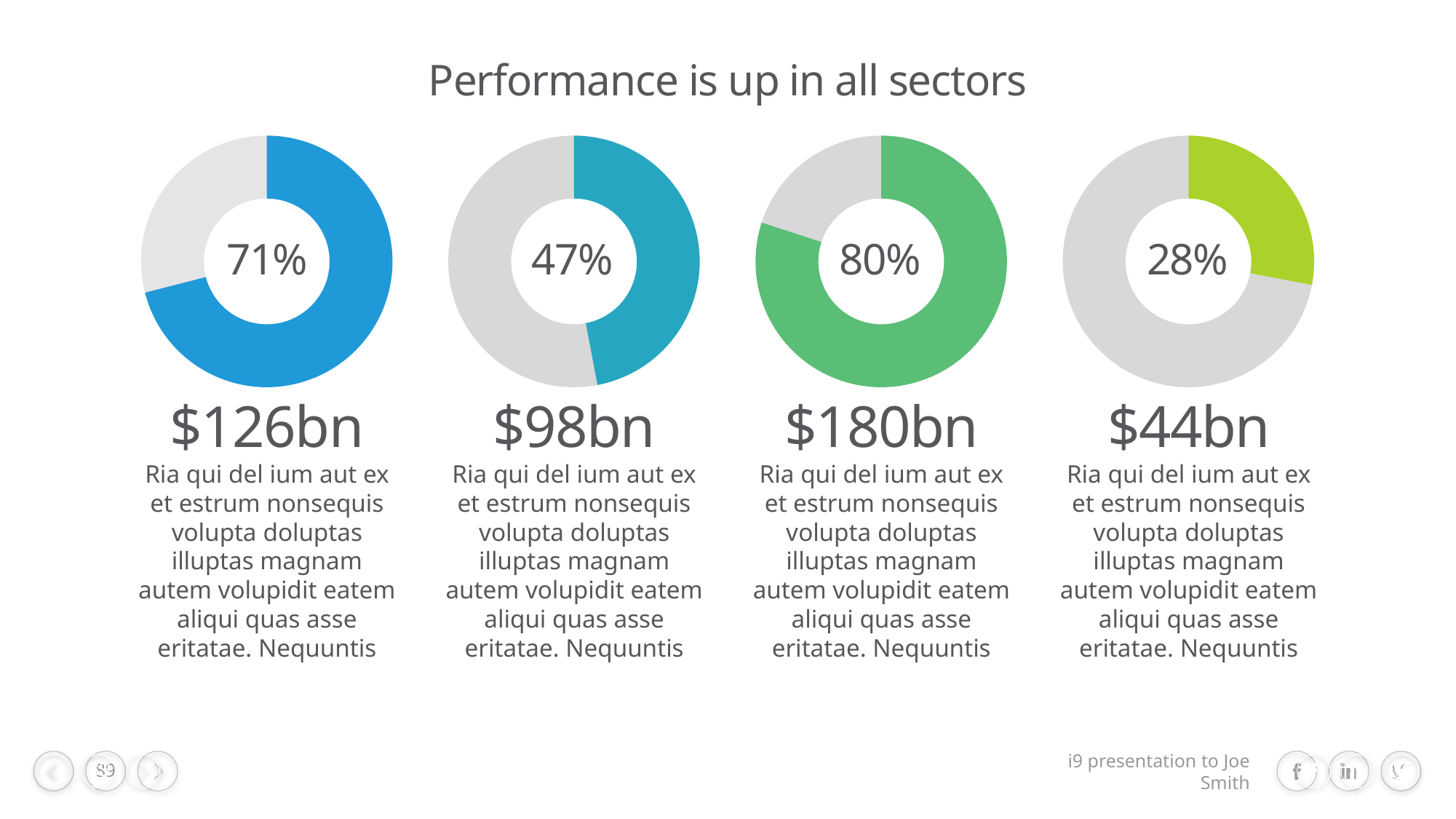
Which donut chart shows the highest percentage: the leftmost, second, third, or rightmost? the third (green), 80% What is the difference between the percentage in the third donut chart (80%) and the percentage in the rightmost donut chart (28%)? 52% What percentage is shown in the centre of the rightmost (lime green) donut chart? 28% What percentage is shown in the centre of the leftmost (blue) donut chart? 71% Which donut chart shows the lowest percentage: the leftmost, second, third, or rightmost? the rightmost (lime green), 28% What percentage is shown in the centre of the third donut chart from the left (green)? 80% What dollar value is printed beneath the rightmost donut chart? $44bn What percentage is shown in the centre of the second donut chart from the left (teal)? 47% What is the title of the slide containing the four donut charts? Performance is up in all sectors How many donut charts are shown on the slide? 4 Which is larger: the percentage in the leftmost donut chart or the percentage in the second donut chart from the left? the leftmost (71%) What dollar value is printed beneath the leftmost donut chart? $126bn